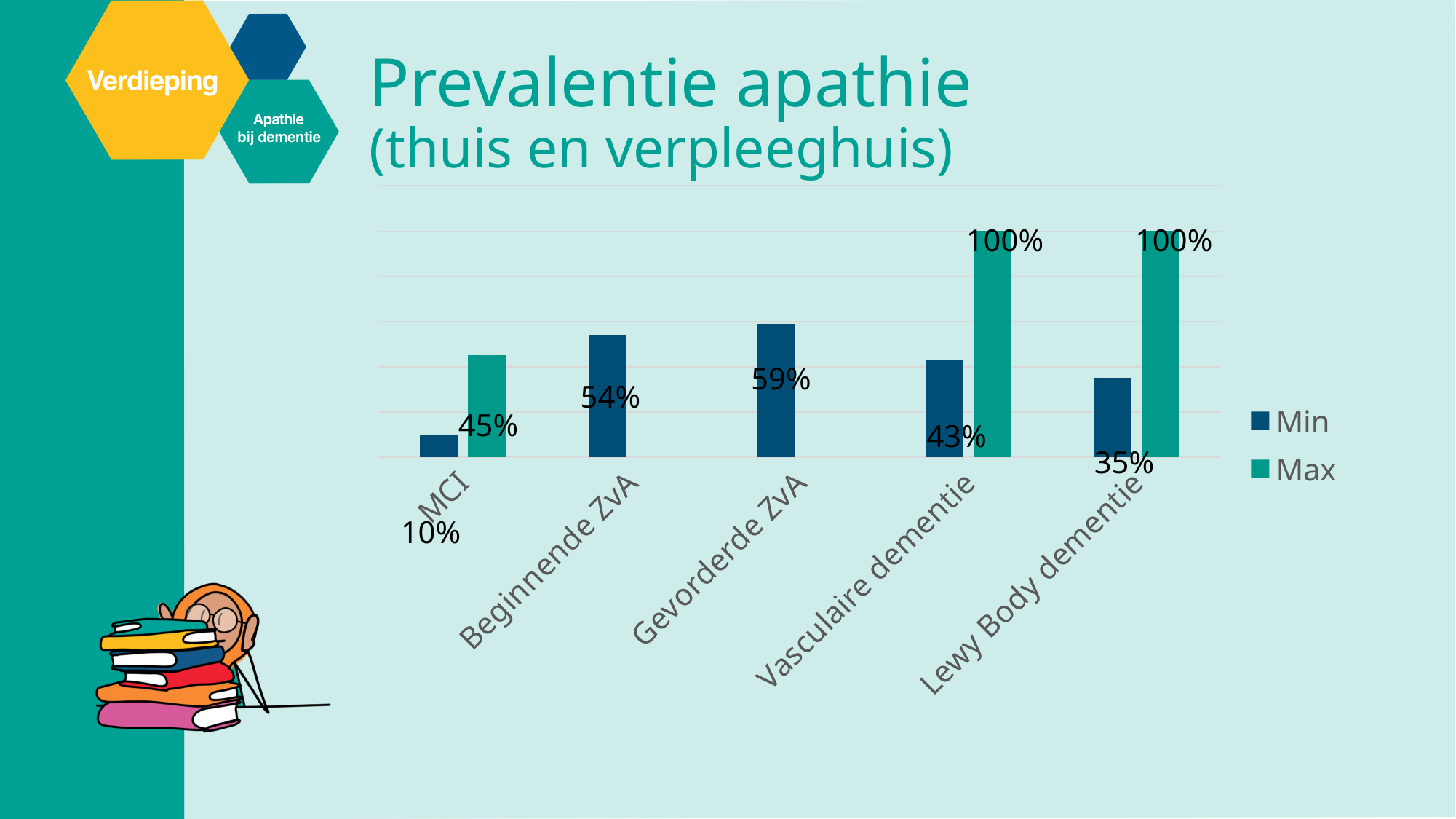
What is the Min value for MCI? 10% What is the Max value for MCI? 45% What is the Min value for Lewy Body dementie? 35% What is the Max value for Vasculaire dementie? 100% What kind of chart is shown on the slide? Bar chart Which is larger, the Min value for Vasculaire dementie or the Min value for Lewy Body dementie? Vasculaire dementie Which category has the lowest Min value? MCI Which category has the highest Min value? Gevorderde ZvA What is the Min value for Gevorderde ZvA? 59% What is the difference between the Max and Min values for MCI? 35% How many series does the legend list? 2 What is the Min value for Beginnende ZvA? 54%